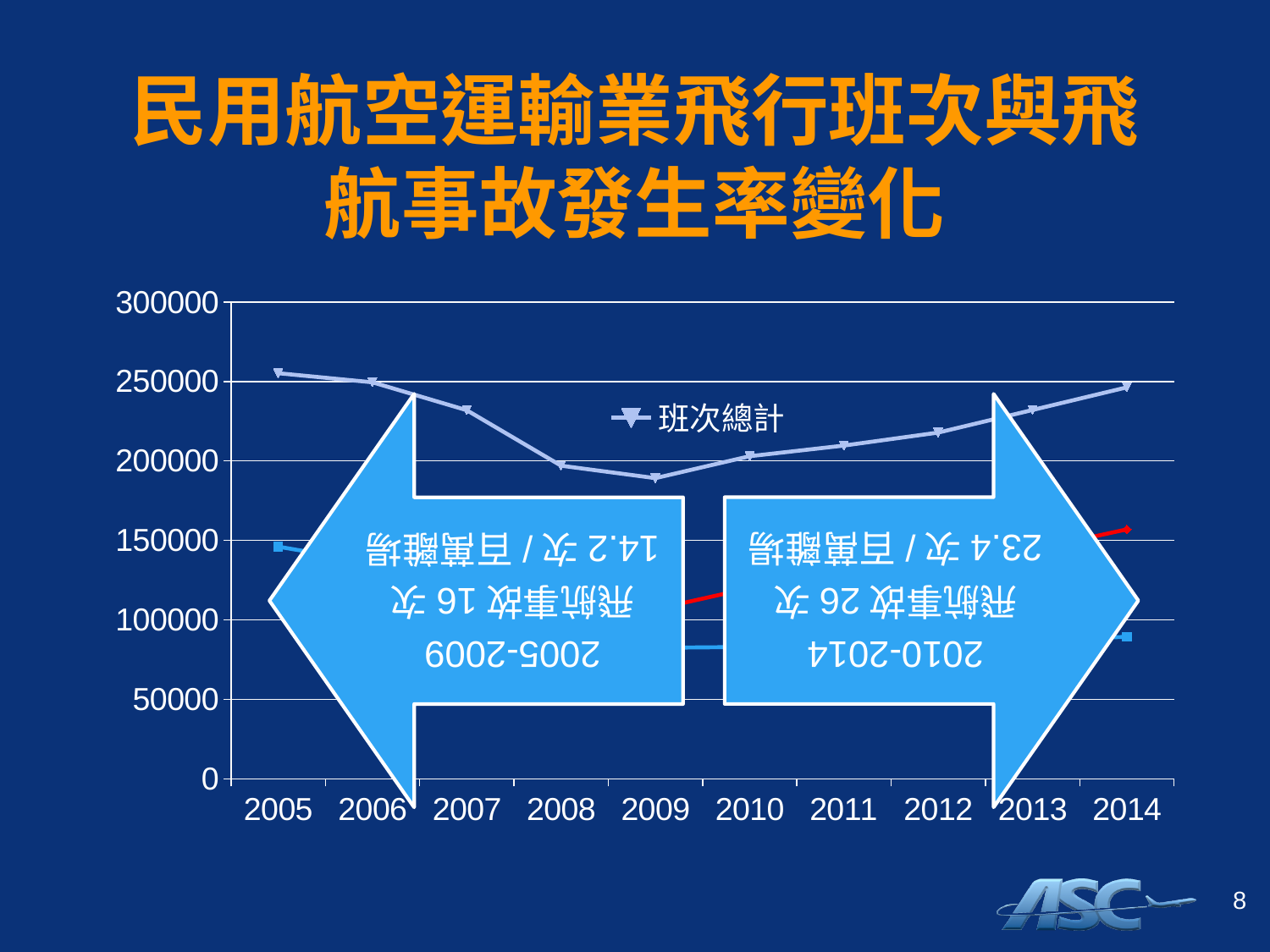
Which year has the lowest value for 班次總計? 2009 What kind of chart is shown on the slide? line chart Does the 班次總計 line rise or fall from 2005 to 2009? fall What series name is shown in the chart's legend? 班次總計 Which year has the larger value for 班次總計, 2007 or 2012? 2007 Is the value for 班次總計 in 2011 greater or less than 200000? greater How many years are shown on the x axis of the chart? 10 Does the 班次總計 line rise or fall from 2009 to 2014? rise Is the value for 班次總計 in 2009 greater or less than 200000? less Is the value for 班次總計 in 2005 greater or less than 250000? greater Which year has the highest value for 班次總計? 2005